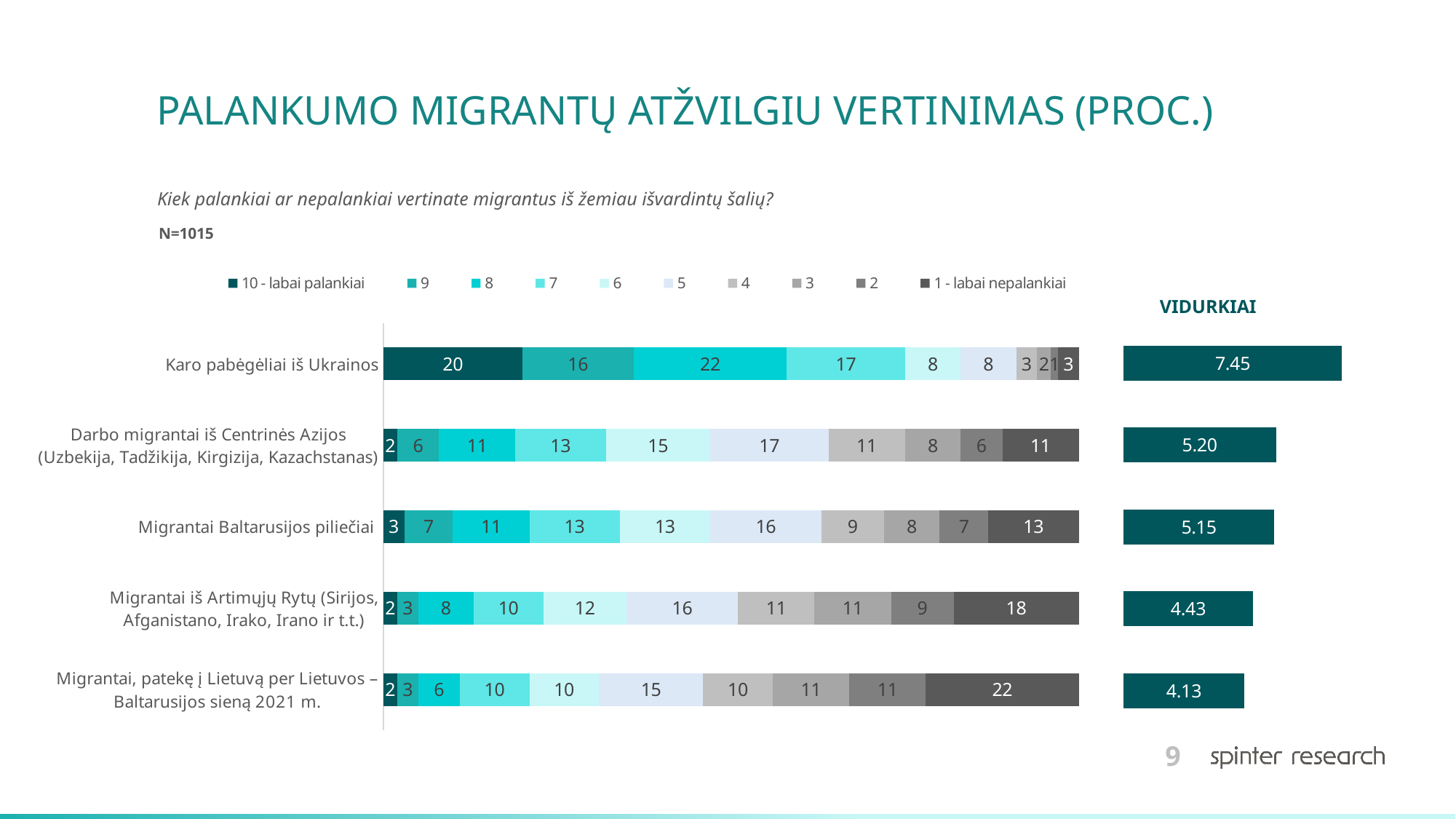
What is the '5' rating share for 'Darbo migrantai iš Centrinės Azijos (Uzbekija, Tadžikija, Kirgizija, Kazachstanas)'? 17 What is the difference between the highest average (7.45) and the lowest average (4.13) in the VIDURKIAI column? 3.32 Which group has a larger '1 - labai nepalankiai' share: 'Migrantai iš Artimųjų Rytų (Sirijos, Afganistano, Irako, Irano ir t.t.)' or 'Migrantai Baltarusijos piliečiai'? Migrantai iš Artimųjų Rytų (Sirijos, Afganistano, Irako, Irano ir t.t.) Which migrant group has the lowest average (VIDURKIAI) value? Migrantai, patekę į Lietuvą per Lietuvos – Baltarusijos sieną 2021 m. How many series does the legend list? 10 What is the title of the chart on the slide? PALANKUMO MIGRANTŲ ATŽVILGIU VERTINIMAS (PROC.) What is the average (VIDURKIAI) value for 'Migrantai Baltarusijos piliečiai'? 5.15 Which migrant group has the highest average (VIDURKIAI) value? Karo pabėgėliai iš Ukrainos What kind of chart is shown on the slide? Stacked bar chart What percentage of respondents rated 'Migrantai, patekę į Lietuvą per Lietuvos – Baltarusijos sieną 2021 m.' as '1 - labai nepalankiai'? 22 What percentage of respondents rated 'Karo pabėgėliai iš Ukrainos' as '10 - labai palankiai'? 20 How many migrant groups (categories) are shown in the chart? 5